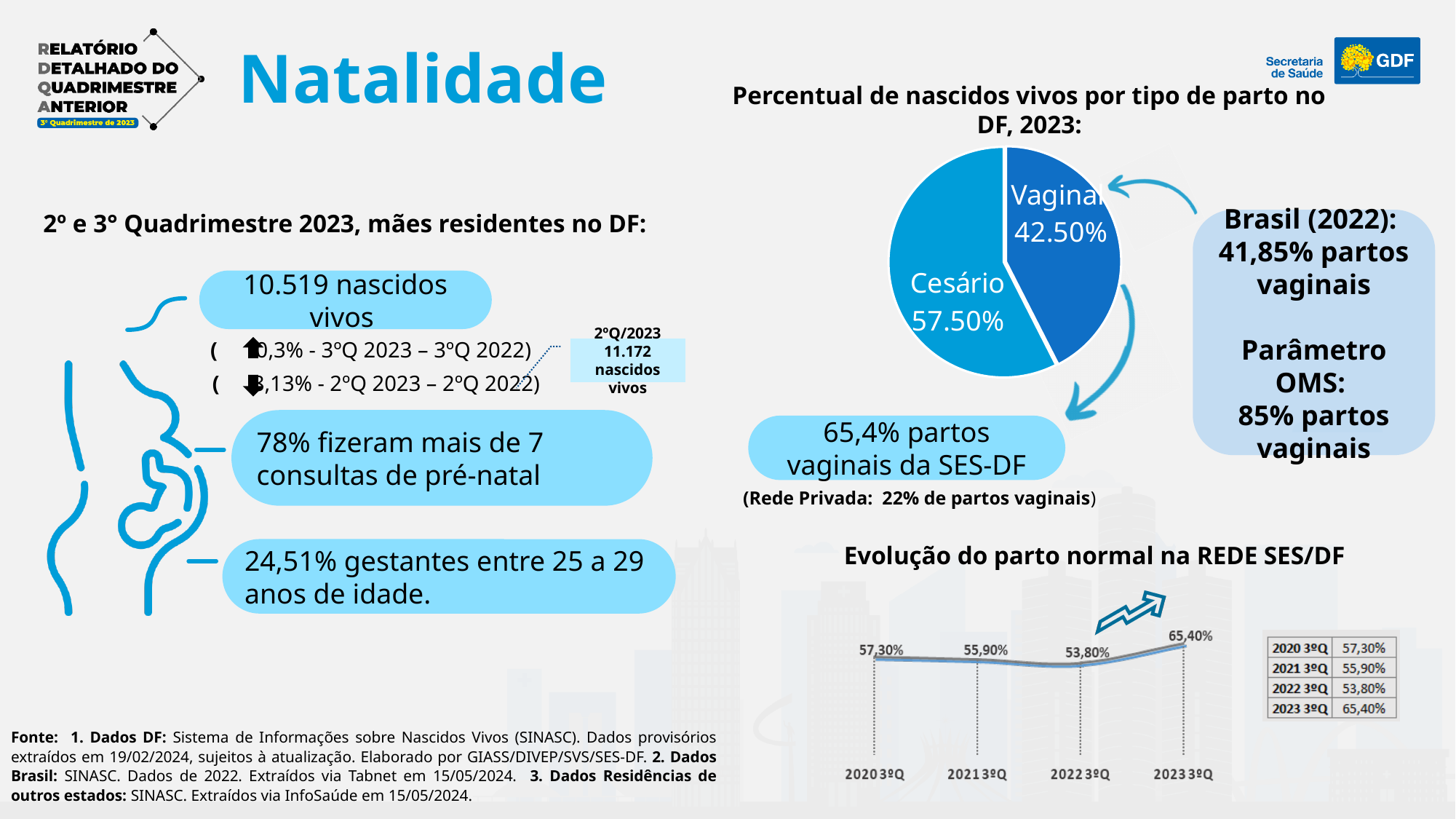
How many slices does the pie chart 'Percentual de nascidos vivos por tipo de parto no DF, 2023' have? 2 In the pie chart 'Percentual de nascidos vivos por tipo de parto no DF, 2023', what is the value for Vaginal? 42.50% What kind of chart is 'Evolução do parto normal na REDE SES/DF'? Line chart In the pie chart 'Percentual de nascidos vivos por tipo de parto no DF, 2023', what is the difference in percentage points between Cesário and Vaginal? 15 percentage points In the chart 'Evolução do parto normal na REDE SES/DF', what is the difference between the 2023 3ºQ and 2022 3ºQ values? 11,60 percentage points In the chart 'Evolução do parto normal na REDE SES/DF', which period has the highest value? 2023 3ºQ In the chart 'Evolução do parto normal na REDE SES/DF', what is the value for 2021 3ºQ? 55,90% In the pie chart 'Percentual de nascidos vivos por tipo de parto no DF, 2023', which type of delivery has the larger share? Cesário What kind of chart is 'Percentual de nascidos vivos por tipo de parto no DF, 2023'? Pie chart In the pie chart 'Percentual de nascidos vivos por tipo de parto no DF, 2023', what is the value for Cesário? 57.50% In the chart 'Evolução do parto normal na REDE SES/DF', what is the value for 2023 3ºQ? 65,40% In the chart 'Evolução do parto normal na REDE SES/DF', which period has the lowest value? 2022 3ºQ